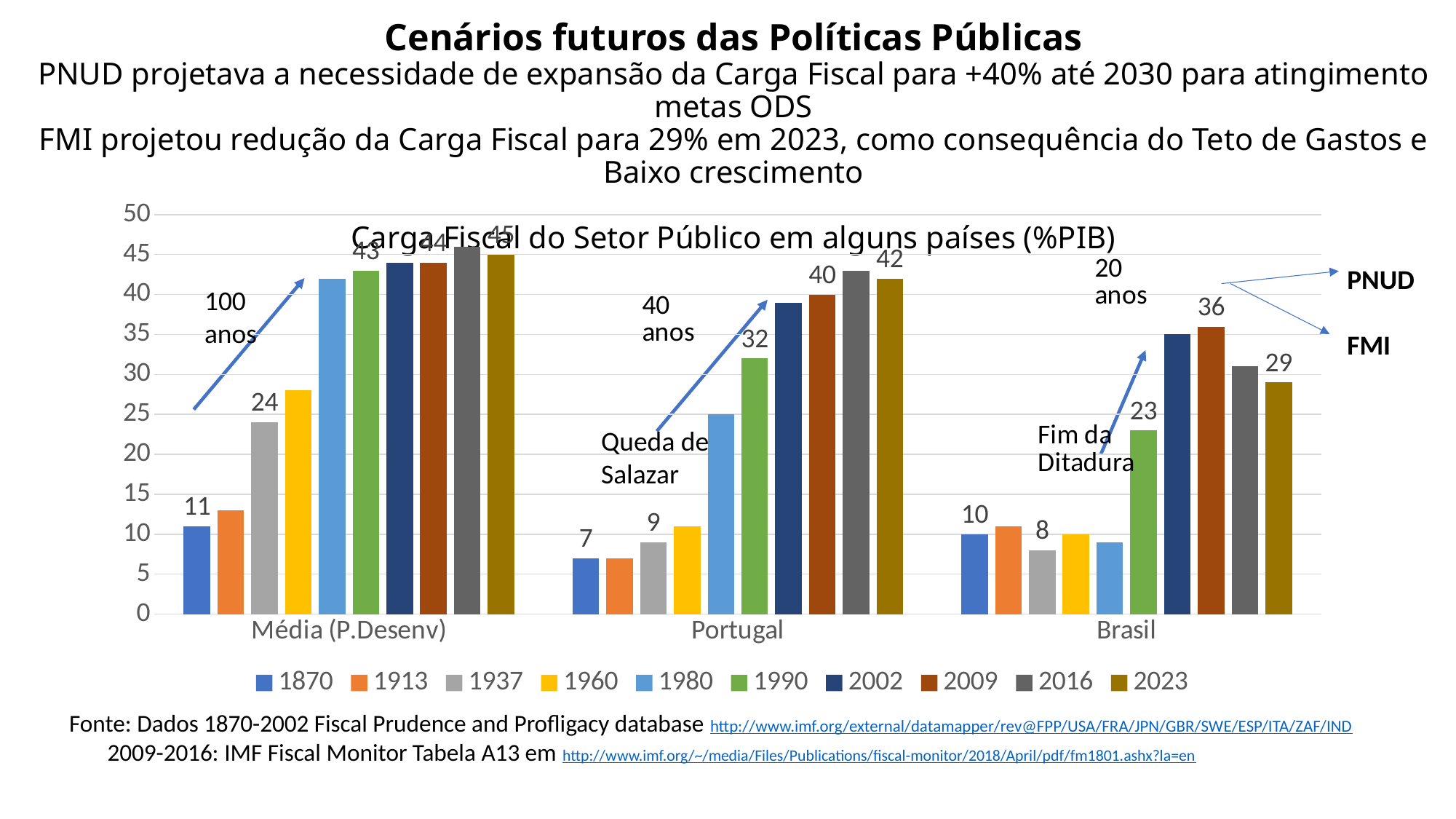
How many series does the legend list? 10 Is the value for Portugal in the 1980 series greater or less than 20? greater What is the difference between the 2023 and 1870 values for Portugal? 35 What is the difference between the 2009 and 2023 values for Brasil? 7 Is the value for Brasil in the 2002 series greater or less than 30? greater What is the value for Média (P.Desenv) in the 1937 series? 24 What is the value for Portugal in the 1990 series? 32 Which category has the lowest value in the 1870 series? Portugal How many categories are shown on the x axis? 3 What is the value for Brasil in the 2009 series? 36 What type of chart is shown on the slide? Bar chart In the 2009 series, which is larger: Portugal or Brasil? Portugal